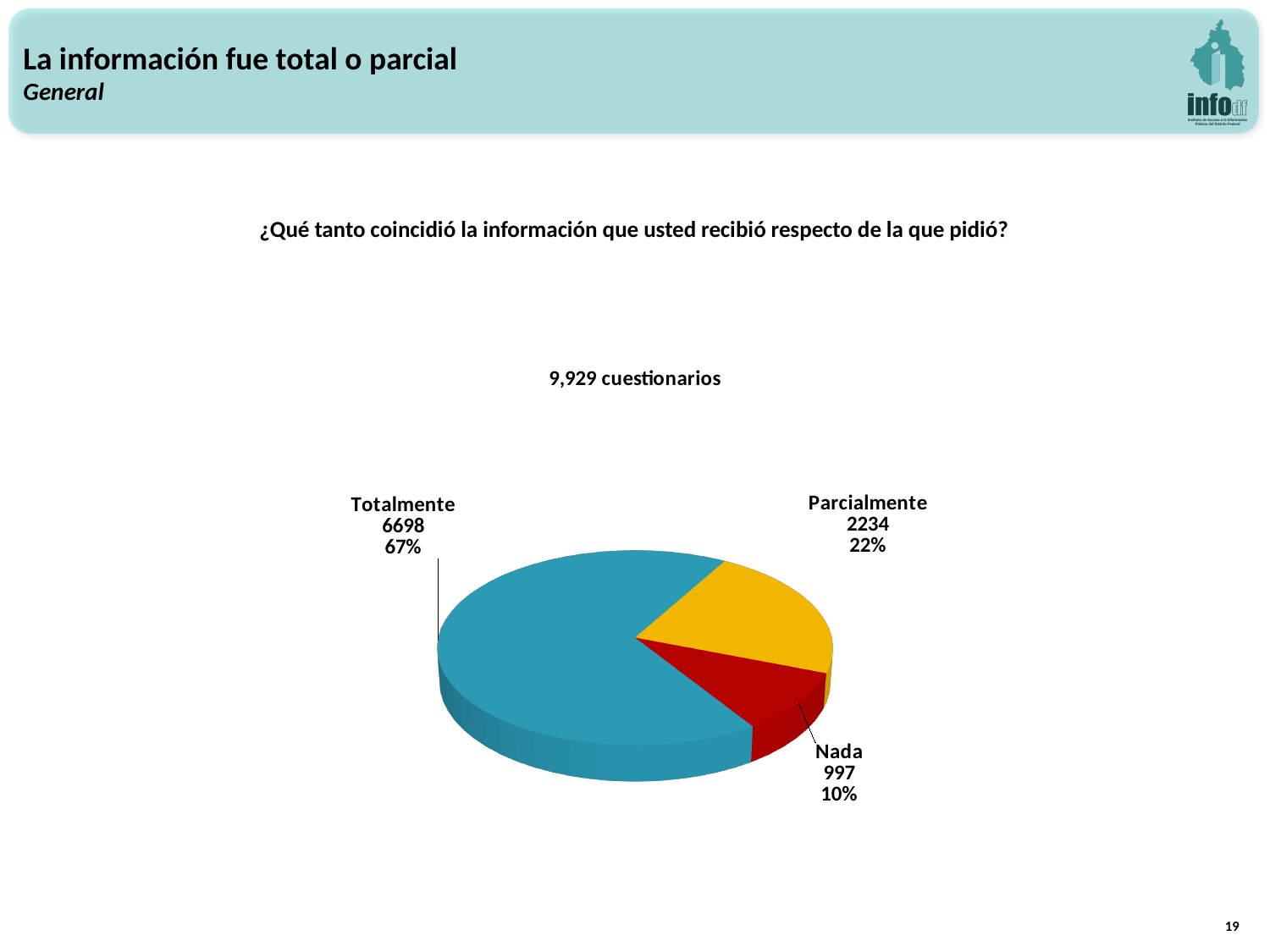
Which category has the largest slice? Totalmente Which category has the smallest slice? Nada What is the difference between the values for Totalmente and Parcialmente? 4464 What is the value for Totalmente? 6698 What kind of chart is shown on the slide? pie chart What share of the pie does Totalmente represent? 67% How many questionnaires does the chart subtitle say were counted? 9,929 cuestionarios Which is larger, the value for Parcialmente or the value for Nada? Parcialmente What is the value for Nada? 997 What is the value for Parcialmente? 2234 How many slices does the pie chart have? 3 What share of the pie does Nada represent? 10%